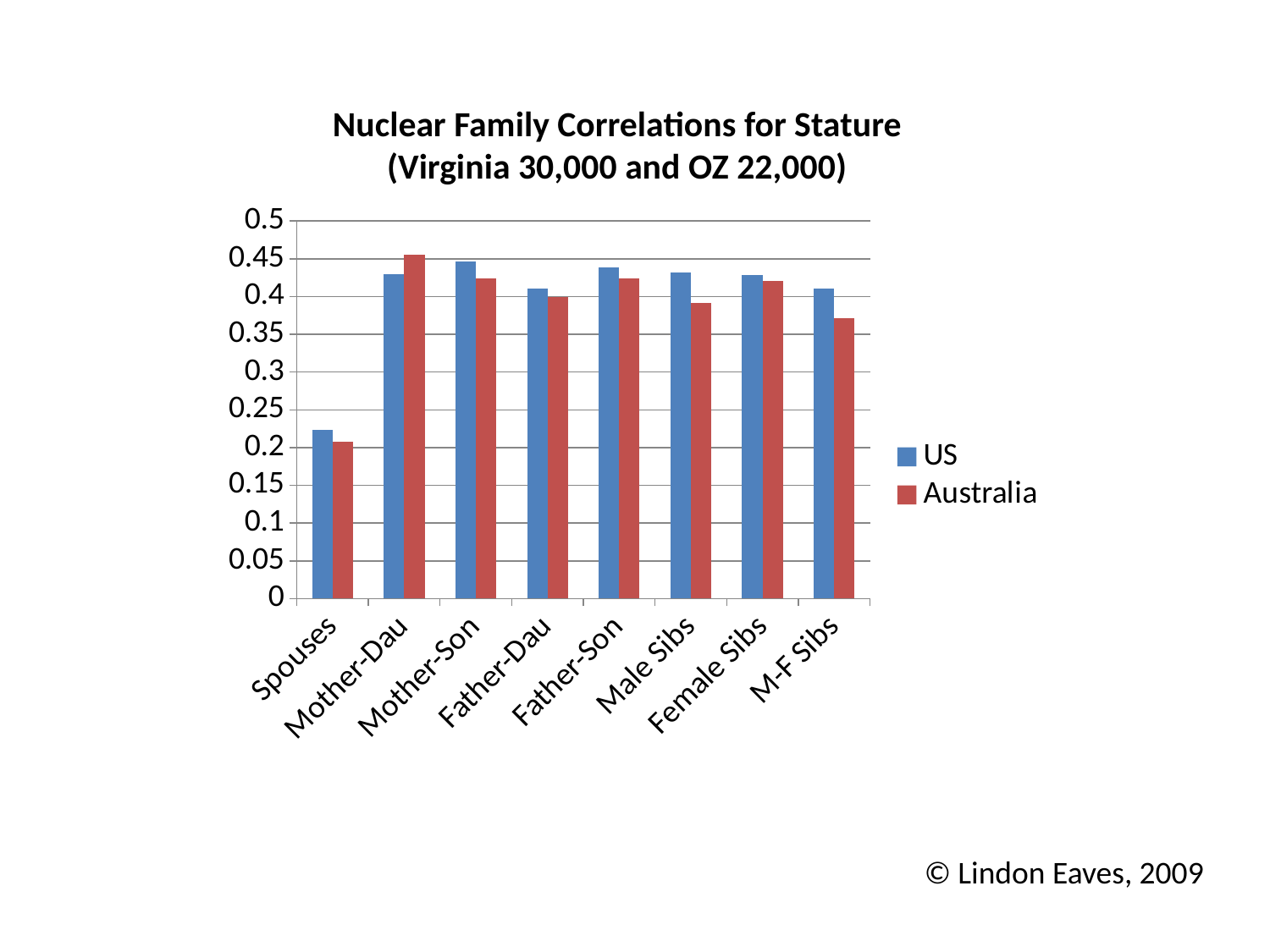
How many series does the legend list? 2 What kind of chart is shown on the slide? bar chart Which category has the highest Australia correlation? Mother-Dau For Mother-Dau, which is larger, the US or the Australia correlation? Australia Which category has the lowest Australia correlation? Spouses Which series is shown in red? Australia Which category has the lowest US correlation? Spouses Is the US value for Spouses greater or less than 0.25? less Is the Australia value for M-F Sibs greater or less than 0.4? less How many family relationship categories are shown on the x axis? 8 For Male Sibs, which is larger, the US or the Australia correlation? US Is the US value for Mother-Son greater or less than 0.4? greater